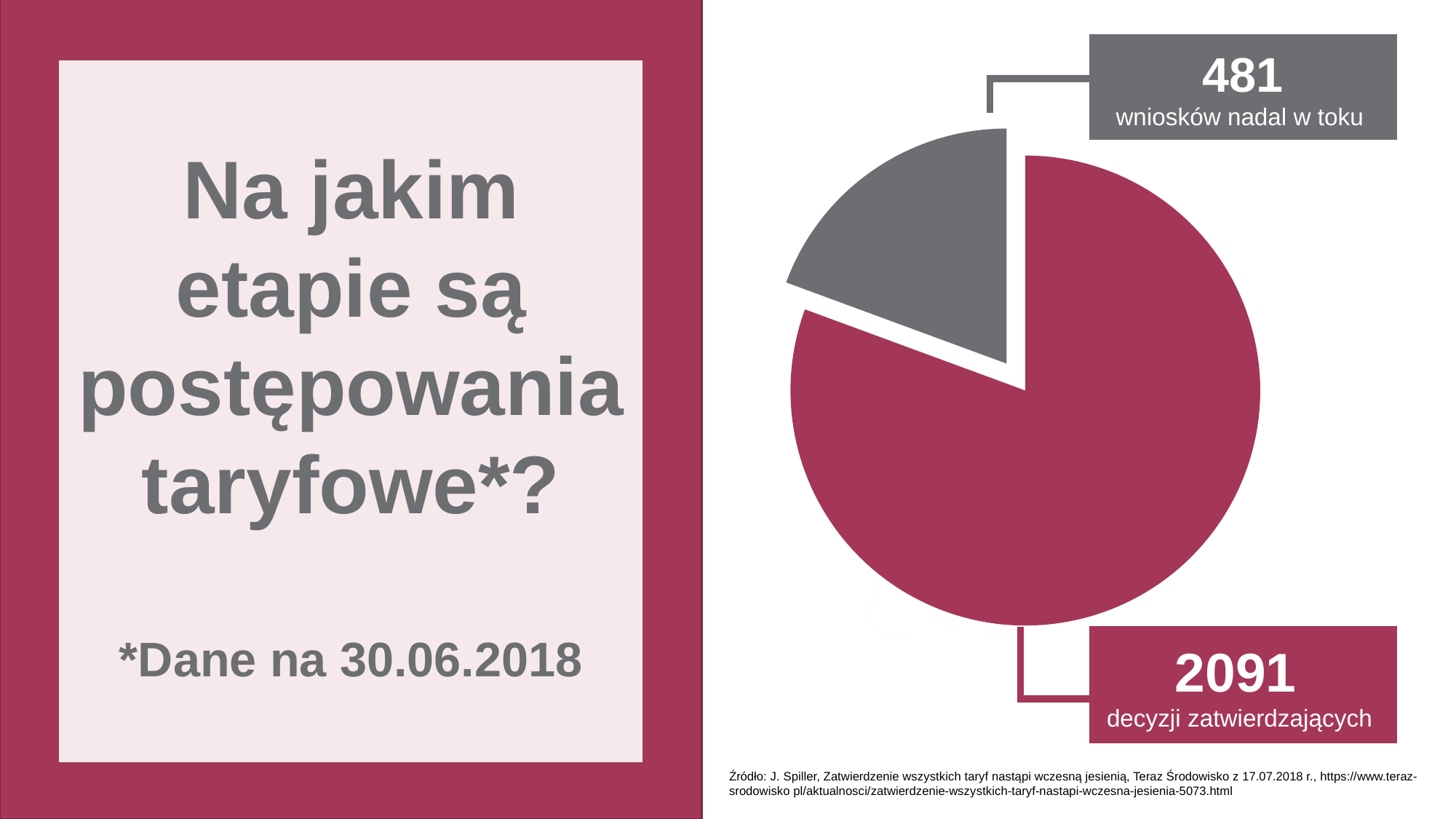
Which category has the larger slice in the pie chart? decyzji zatwierdzających What is the total of the two values shown in the pie chart? 2572 What colour is the slice representing 'wniosków nadal w toku'? grey What kind of chart is shown on the slide? pie chart What is the difference between the number of approving decisions and the number of applications still in progress? 1610 Which category has the smaller slice in the pie chart? wniosków nadal w toku As of what date are the data in the chart reported? 30.06.2018 How many applications are still in progress (wniosków nadal w toku) according to the pie chart? 481 How many slices does the pie chart have? 2 Is the value for 'wniosków nadal w toku' larger or smaller than the value for 'decyzji zatwierdzających'? smaller How many approving decisions (decyzji zatwierdzających) does the pie chart show? 2091